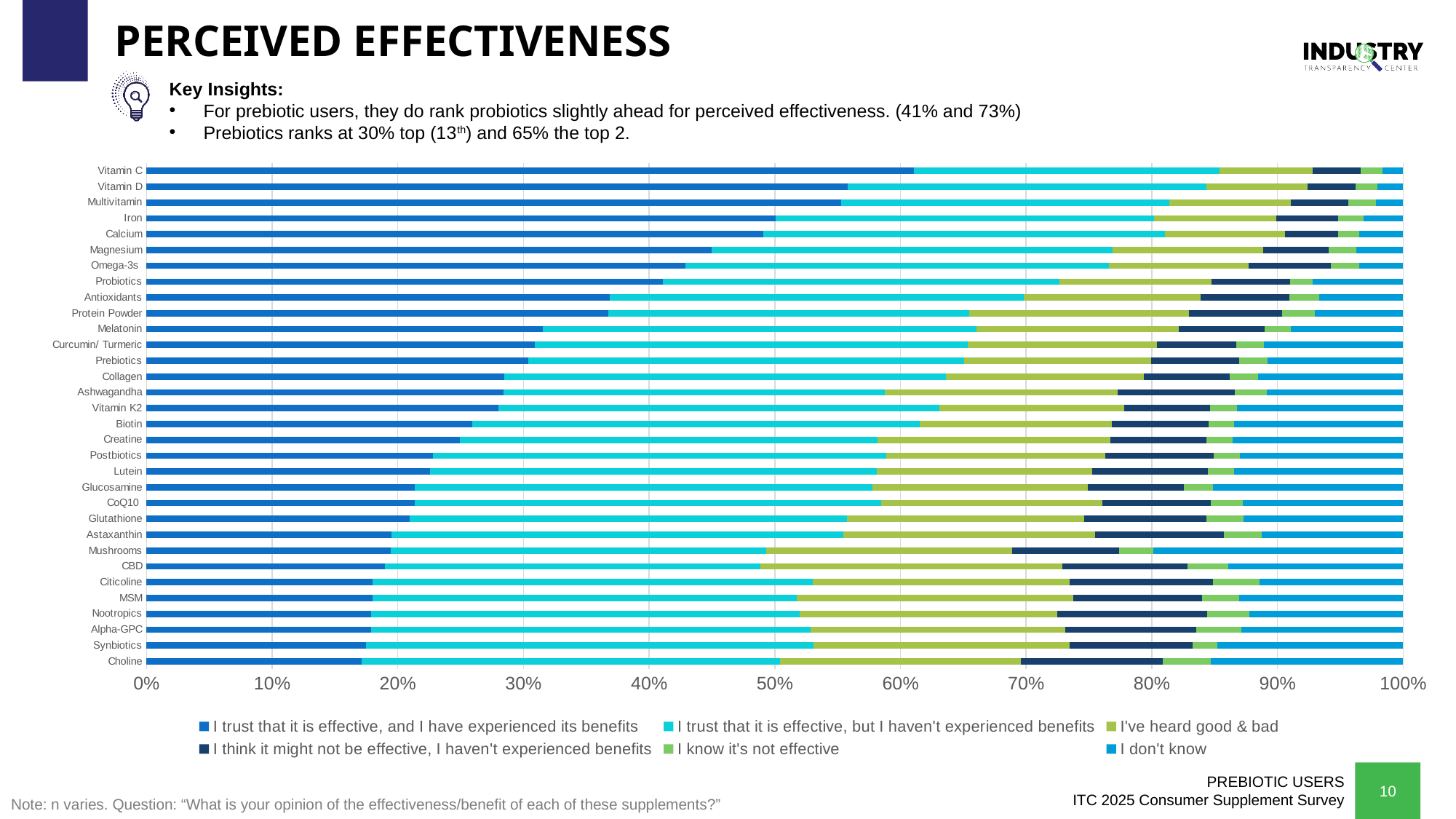
What kind of chart is shown on the slide? Stacked bar chart How many supplements are listed as categories on the chart? 32 Is the 'I trust that it is effective, and I have experienced its benefits' value for Choline greater or less than 20%? less Which has the larger 'I trust that it is effective, and I have experienced its benefits' segment, Vitamin C or Choline? Vitamin C Which supplement is listed at the top of the chart? Vitamin C What is the last legend entry on the chart? I don't know Which supplement has the largest 'I trust that it is effective, and I have experienced its benefits' segment? Vitamin C Is the 'I trust that it is effective, and I have experienced its benefits' value for Magnesium greater or less than 40%? greater What does each stacked bar total? 100% Which has the larger 'I trust that it is effective, and I have experienced its benefits' segment, Probiotics or Prebiotics? Probiotics Is the 'I trust that it is effective, and I have experienced its benefits' value for Vitamin C greater or less than 50%? greater How many series does the legend list? 6